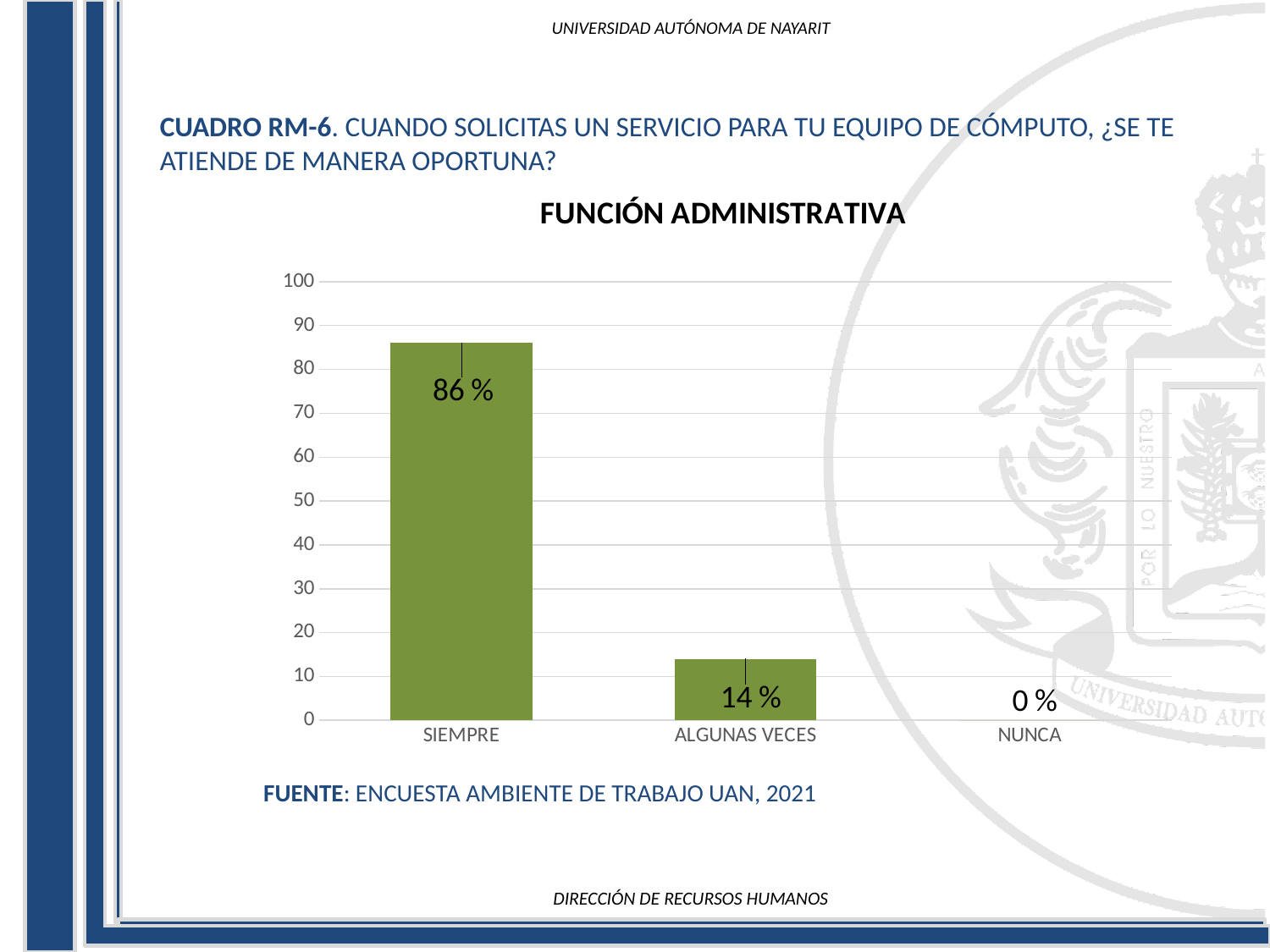
Which is larger, the value for ALGUNAS VECES or the value for NUNCA? ALGUNAS VECES Which category has the highest value? SIEMPRE Is the value for SIEMPRE greater or less than 80? greater What is the value for NUNCA? 0 % Which category has the lowest value? NUNCA What is the title of the chart? FUNCIÓN ADMINISTRATIVA What is the difference between the values for SIEMPRE and ALGUNAS VECES? 72 % What is the value for SIEMPRE? 86 % What is the value for ALGUNAS VECES? 14 % Do the values rise or fall from left to right along the x axis? fall What kind of chart is shown on the slide? bar chart How many categories are shown on the x axis? 3